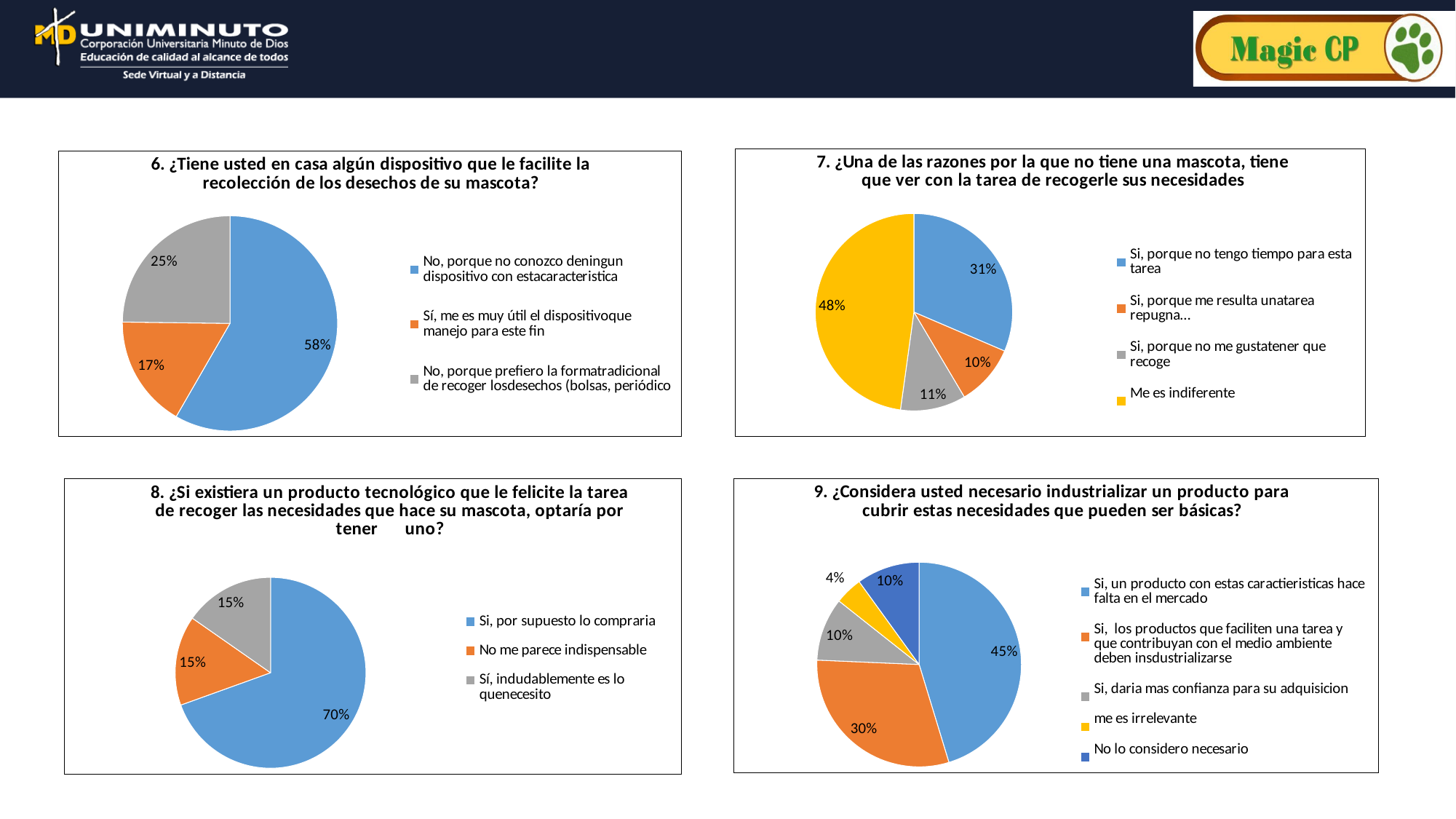
What type of chart is used in the bottom-left chart (question 8)? Pie chart In the top-right chart (question 7), how many categories does the legend list? 4 In the top-right chart (question 7), what percentage is shown for "Me es indiferente"? 48% In the bottom-right chart (question 9), what percentage is shown for "me es irrelevante"? 4% In the top-right chart (question 7), which category has the largest slice? Me es indiferente In the top-left chart (question 6), what share of the pie corresponds to "No, porque no conozco de ningun dispositivo con esta caracteristica"? 58% In the bottom-right chart (question 9), what is the combined share of the two largest slices (45% and 30%)? 75% In the top-left chart (question 6), what is the difference between the largest slice and the 25% slice? 33% In the top-left chart (question 6), which category has the smallest slice? Sí, me es muy útil el dispositivo que manejo para este fin In the top-right chart (question 7), which is larger: "Si, porque no tengo tiempo para esta tarea" or "Si, porque no me gusta tener que recoge"? Si, porque no tengo tiempo para esta tarea In the bottom-left chart (question 8), what percentage is shown for "Si, por supuesto lo compraria"? 70% How many pie charts are shown on the slide? 4